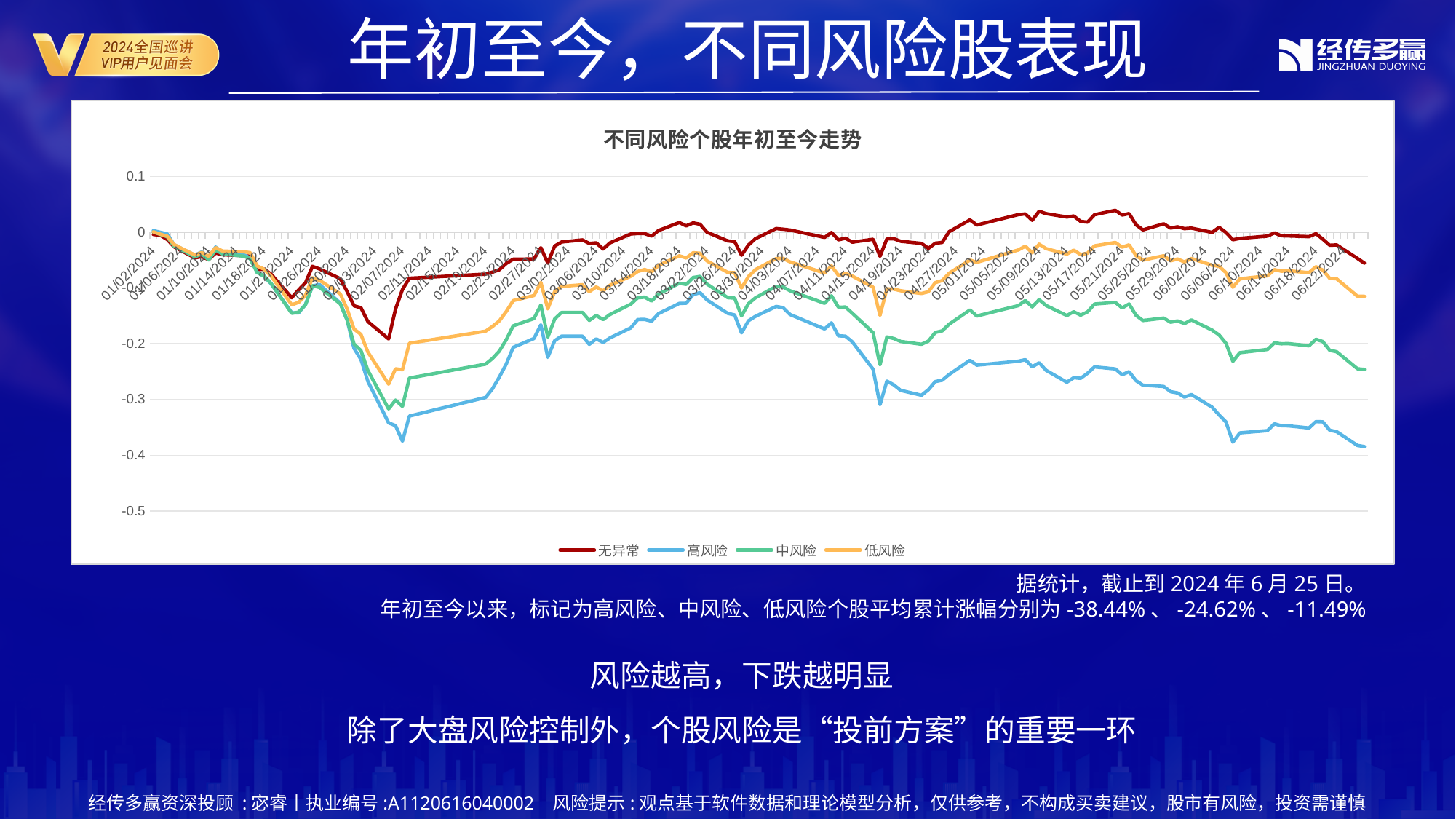
Which series is the highest at the right end of the chart? 无异常 Is the value of the 无异常 line at the right end of the chart greater or less than -0.1? greater Is the value of the 高风险 line at the right end of the chart greater or less than -0.3? less Is the value of the 低风险 line at the right end of the chart greater or less than -0.2? greater Which series is the lowest at the right end of the chart? 高风险 Does the 高风险 line rise or fall from the start of the chart to its end? fall Which colour is used for the 高风险 line in the chart? blue How many series does the chart legend list? 4 What is the title of the chart? 不同风险个股年初至今走势 What kind of chart is shown on the slide? line chart At the right end of the chart, which is higher: 中风险 or 低风险? 低风险